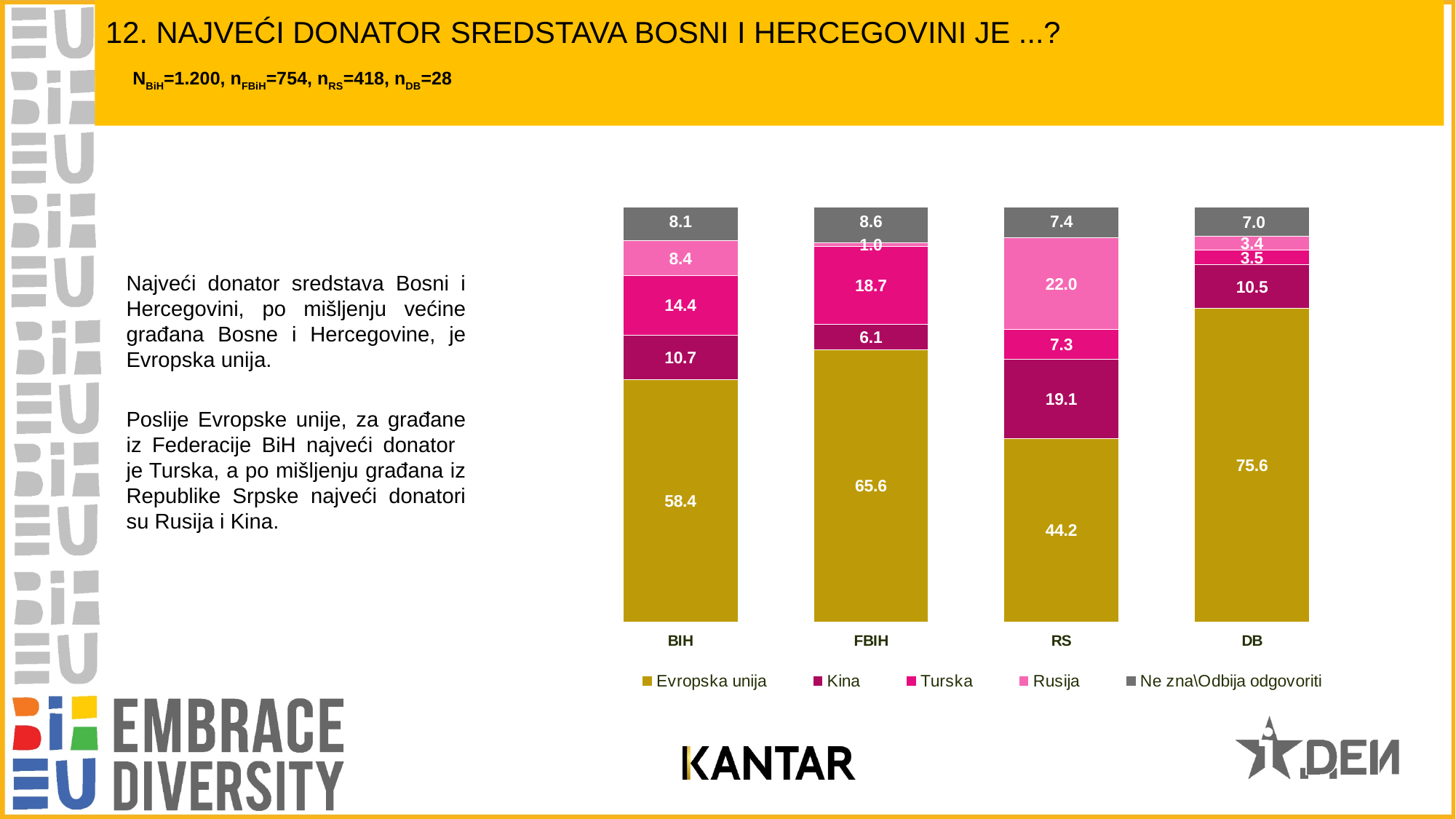
What is the difference between the Turska values for FBIH and RS? 11.4 What is the value for Evropska unija in the RS bar? 44.2 Which is larger, the Kina value for RS or the Kina value for BIH? RS Which category has the highest value for Evropska unija? DB Which category has the lowest value for Rusija? FBIH What is the value for Kina in the FBIH bar? 6.1 What is the value for Rusija in the RS bar? 22.0 What is the total of the stacked bar for BIH? 100.0 Which legend entry is shown in grey? Ne zna\Odbija odgovoriti How many categories are shown on the x axis? 4 How many series does the legend list? 5 What type of chart is shown on the slide? stacked bar chart